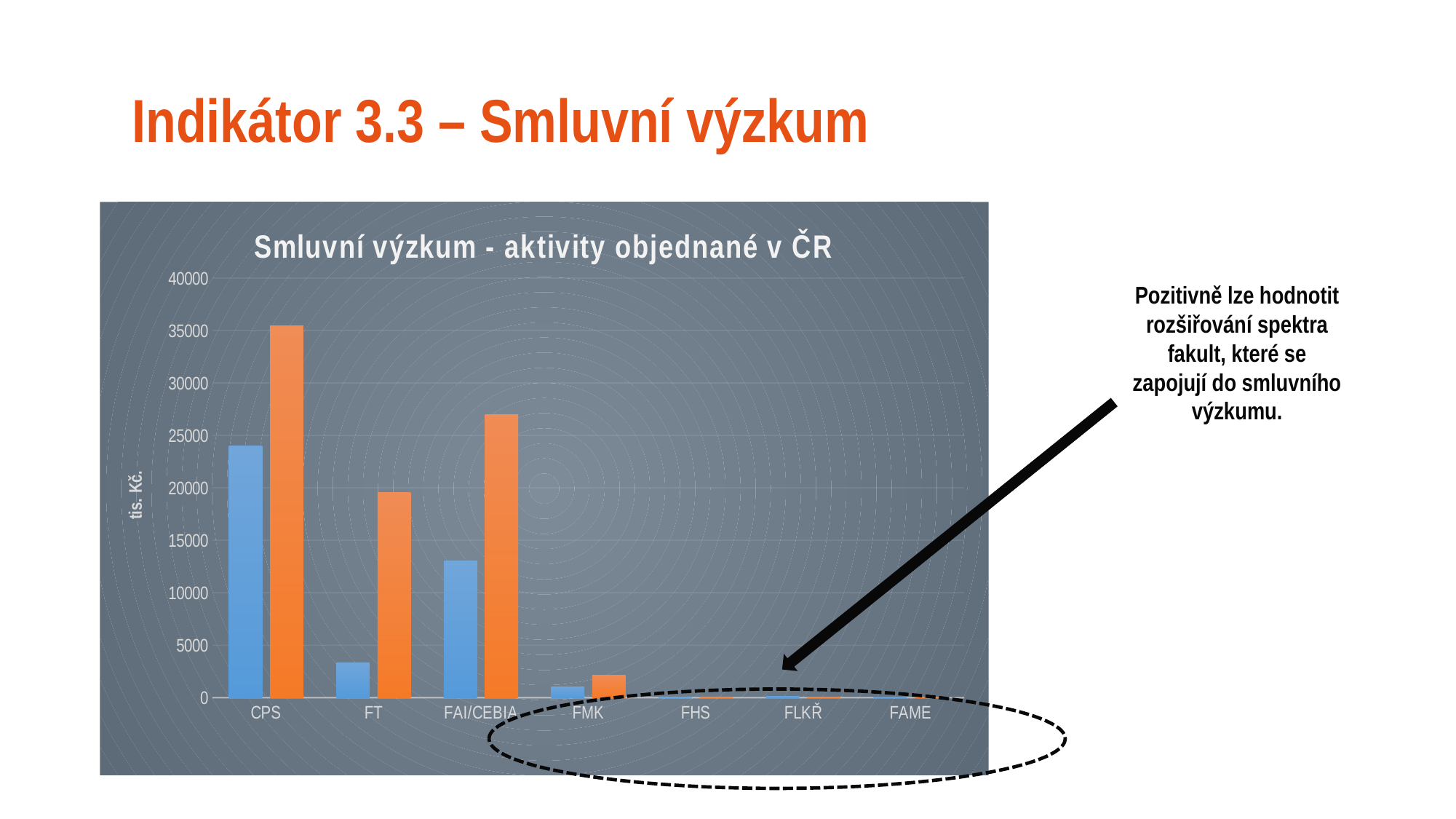
Is the blue bar for FT greater or less than 5000? less Which category has the tallest blue bar? CPS What is the title of the chart? Smluvní výzkum - aktivity objednané v ČR Is the blue bar for CPS greater or less than 25000? less For FT, which bar is larger, the blue one or the orange one? the orange one Which is larger, the orange bar for CPS or the orange bar for FAI/CEBIA? CPS Is the orange bar for FAI/CEBIA greater or less than 25000? greater What is the label on the vertical axis of the chart? tis. Kč. Which category has the tallest orange bar? CPS How many categories are shown on the x axis of the chart? 7 What kind of chart is shown on the slide? bar chart